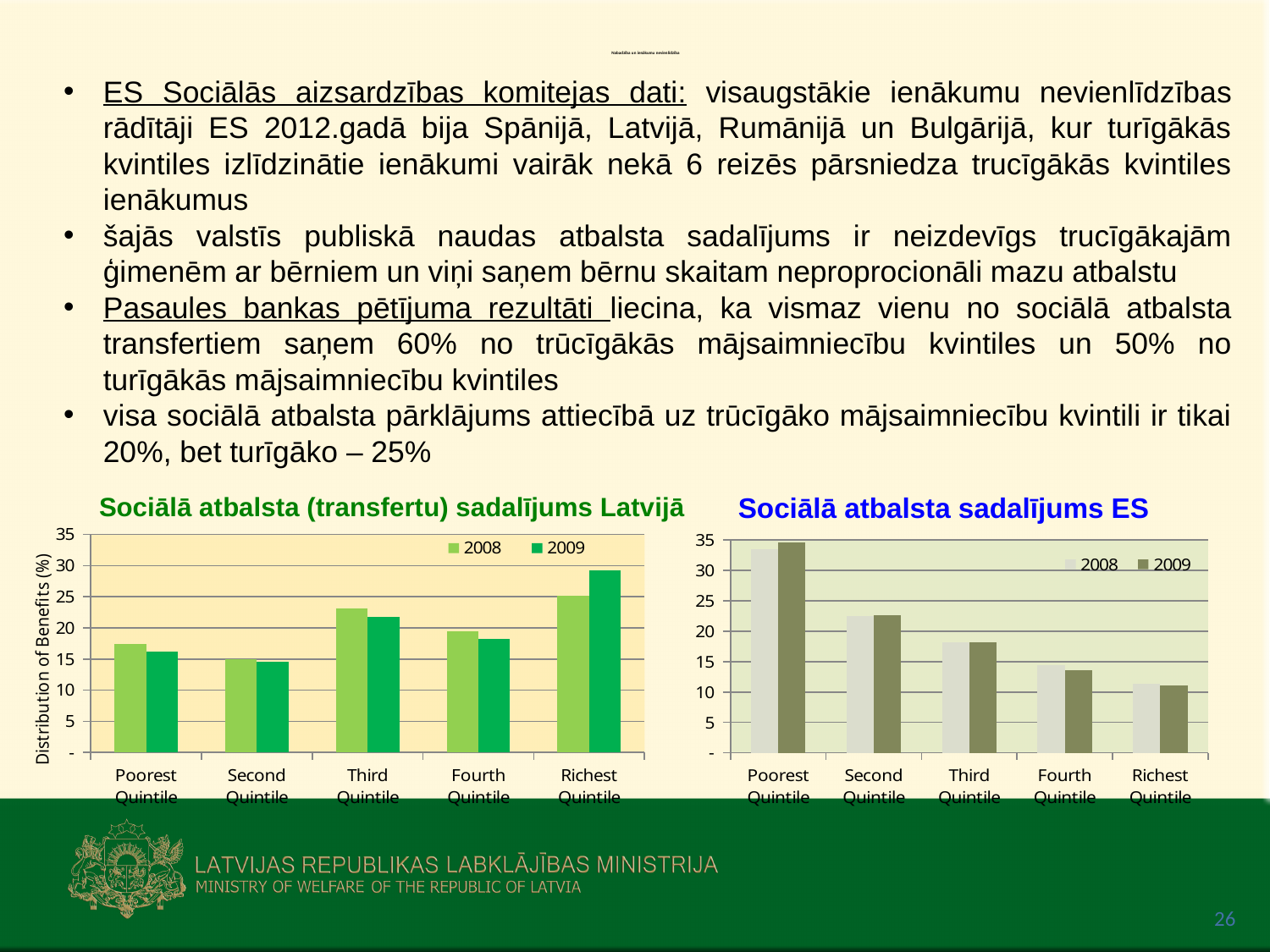
What kind of chart is the left chart titled 'Sociālā atbalsta (transfertu) sadalījums Latvijā'? Bar chart What is the label of the y axis on the left chart 'Sociālā atbalsta (transfertu) sadalījums Latvijā'? Distribution of Benefits (%) How many series does the legend of the right chart 'Sociālā atbalsta sadalījums ES' list? 2 How many quintile categories are shown on the x axis of the left chart 'Sociālā atbalsta (transfertu) sadalījums Latvijā'? 5 In the left chart 'Sociālā atbalsta (transfertu) sadalījums Latvijā', which is larger for the Richest Quintile: the 2008 value or the 2009 value? 2009 In the left chart 'Sociālā atbalsta (transfertu) sadalījums Latvijā', is the 2009 value for the Richest Quintile greater or less than 25? greater In the right chart 'Sociālā atbalsta sadalījums ES', is the 2009 value for the Poorest Quintile greater or less than 30? greater In the right chart 'Sociālā atbalsta sadalījums ES', which quintile has the highest value for 2009? Poorest Quintile In the right chart 'Sociālā atbalsta sadalījums ES', which quintile has the lowest value for 2008? Richest Quintile In the left chart 'Sociālā atbalsta (transfertu) sadalījums Latvijā', which quintile has the highest value for 2009? Richest Quintile In the right chart 'Sociālā atbalsta sadalījums ES', do the 2008 values rise or fall from the Poorest Quintile to the Richest Quintile? Fall In the left chart 'Sociālā atbalsta (transfertu) sadalījums Latvijā', which quintile has the lowest value for 2008? Second Quintile